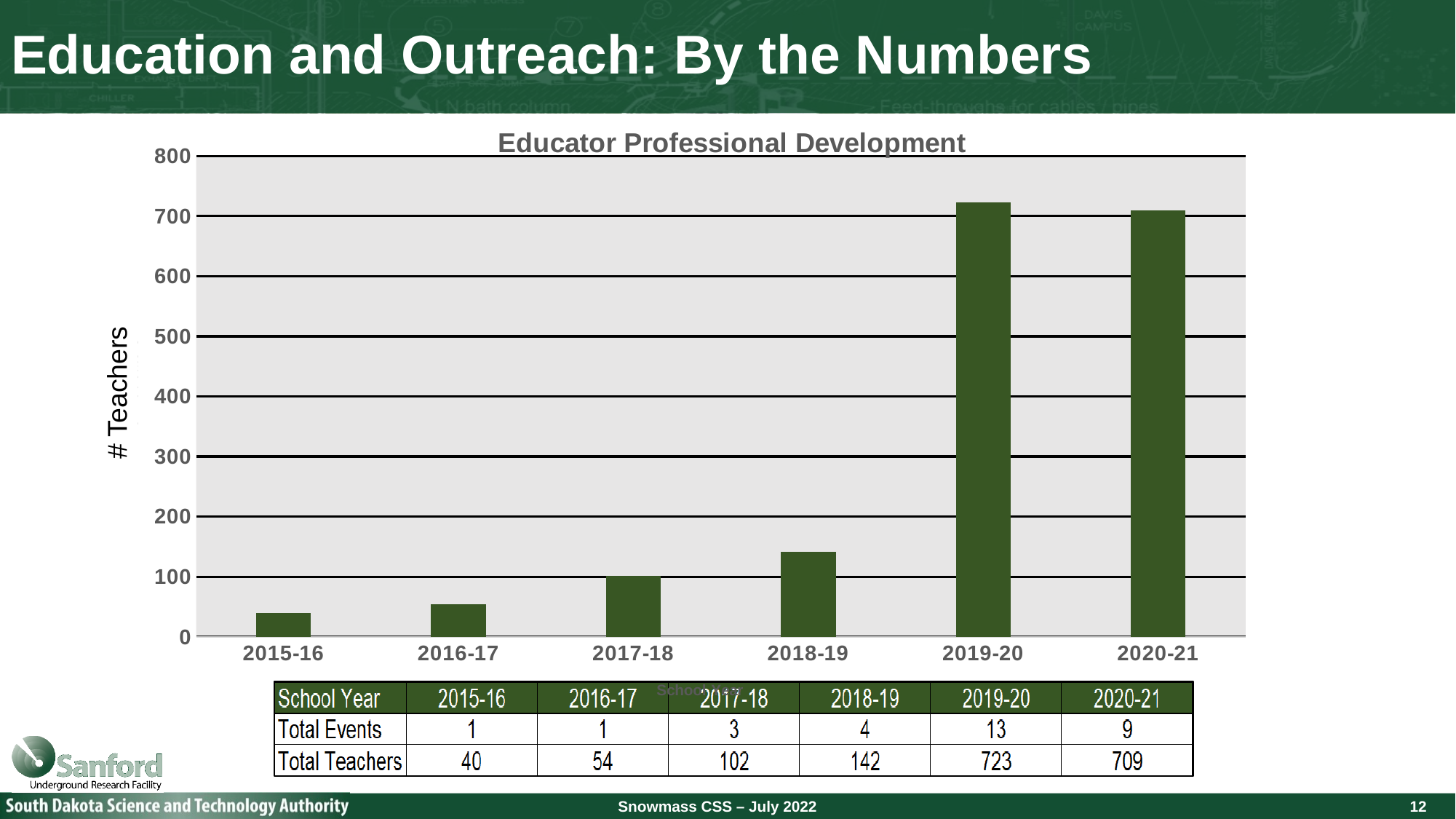
What is the title of the chart? Educator Professional Development Which school year has the lowest number of teachers? 2015-16 Is the value for 2018-19 greater or less than 200? less Which school year has the highest number of teachers? 2019-20 How many school years are plotted in the chart? 6 According to the table, how many total events were held in 2018-19? 4 What is the difference in total teachers between 2019-20 and 2020-21? 14 What type of chart is shown on the slide? bar chart According to the table, how many total teachers were there in 2015-16? 40 According to the table, how many total teachers were there in 2019-20? 723 What is the label on the vertical axis? # Teachers Which school year had more teachers, 2017-18 or 2018-19? 2018-19